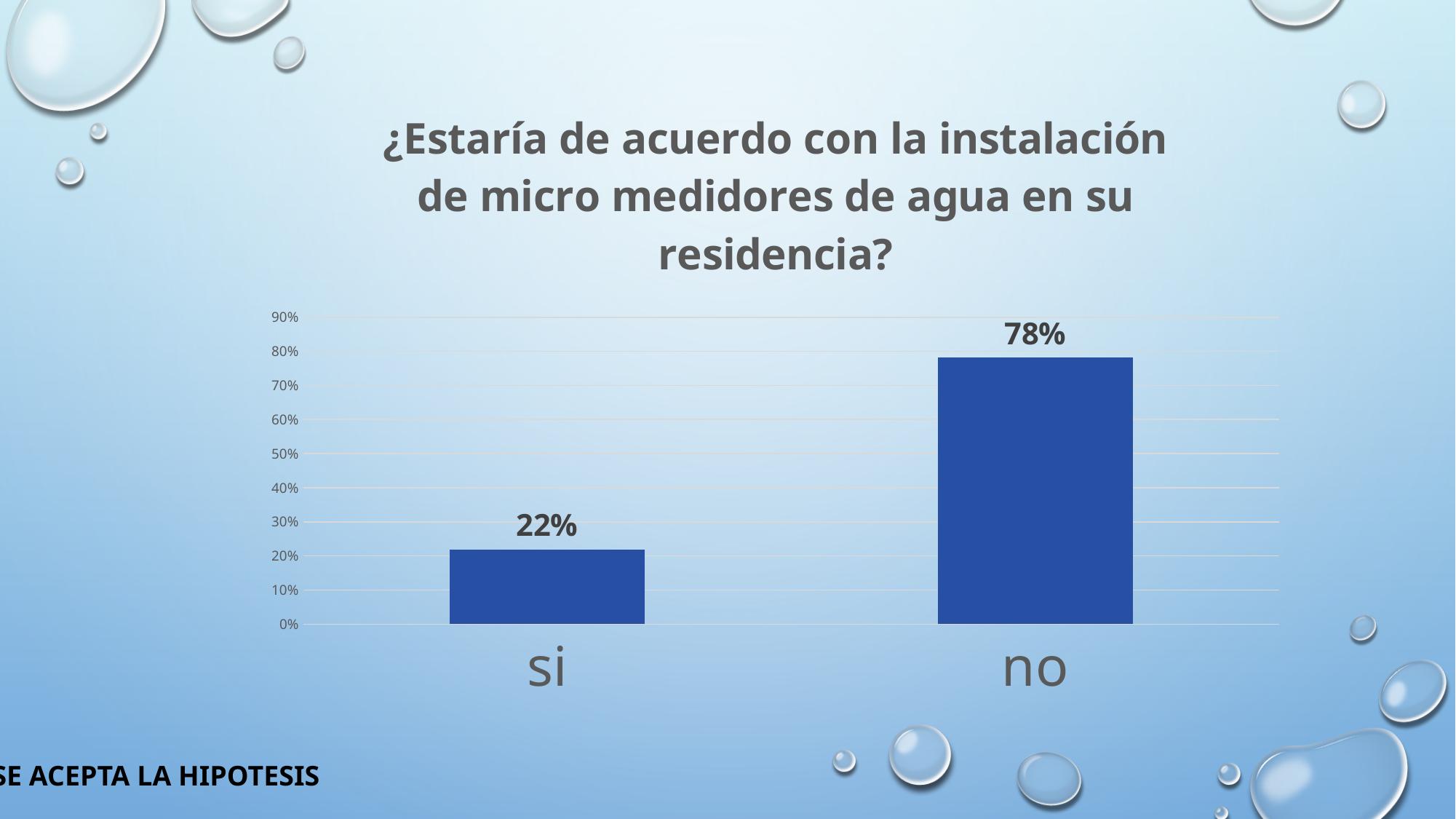
What is the value for "si"? 22% Which is larger, the value for "si" or the value for "no"? no Is the value for "no" greater or less than 50%? greater What is the value for "no"? 78% What kind of chart is shown on the slide? bar chart How many categories are shown in the chart? 2 Which category has the lowest value? si What is the difference between the values for "no" and "si"? 56% Is the value for "si" greater or less than 30%? less What is the highest value shown on the vertical axis? 90% What is the title of the chart? ¿Estaría de acuerdo con la instalación de micro medidores de agua en su residencia? Which category has the highest value? no